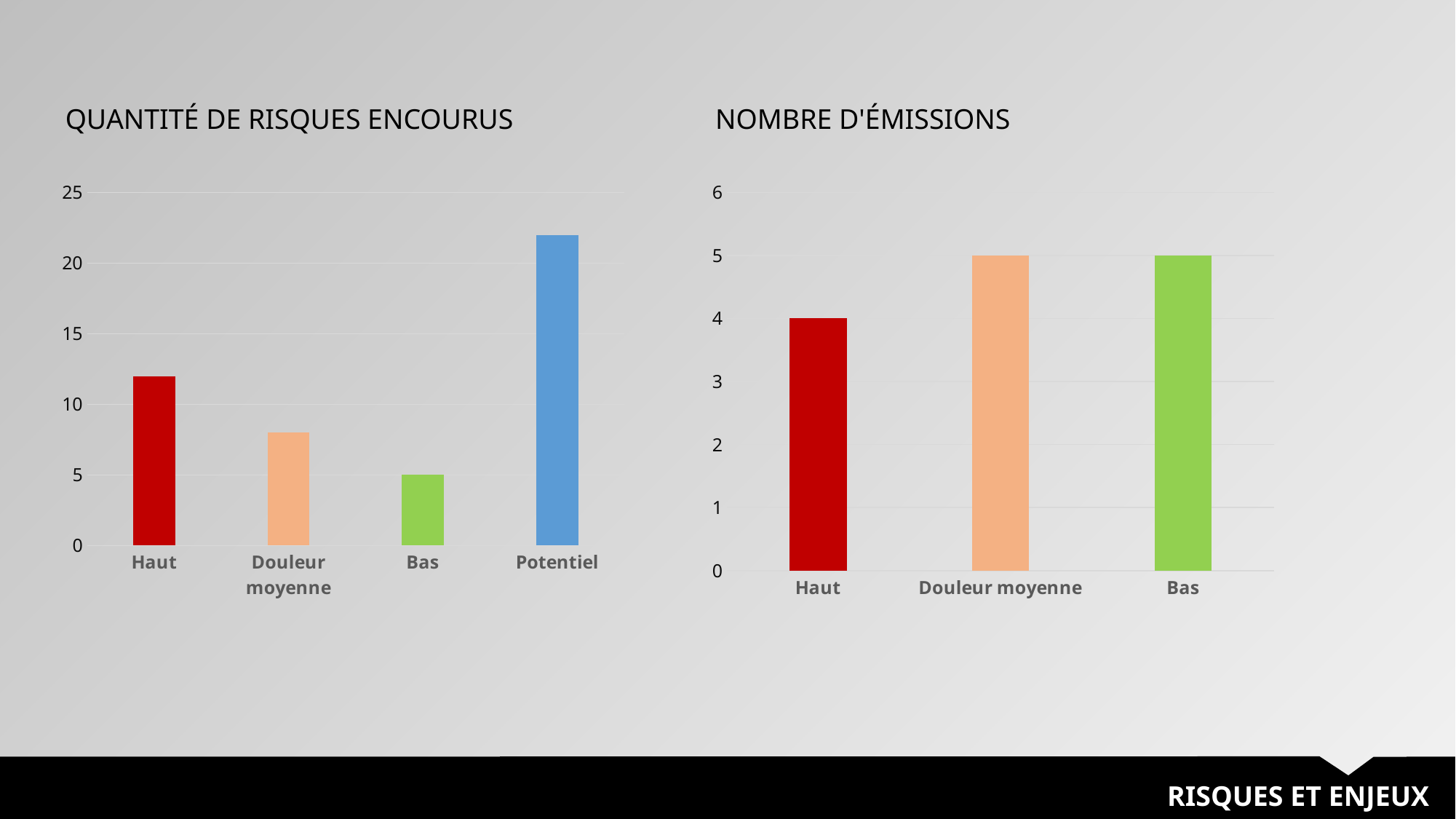
In the chart titled NOMBRE D'ÉMISSIONS, what is the value for Haut? 4 In the chart titled QUANTITÉ DE RISQUES ENCOURUS, which is larger, Haut or Douleur moyenne? Haut In the chart titled NOMBRE D'ÉMISSIONS, what is the difference between the values for Bas and Haut? 1 In the chart titled QUANTITÉ DE RISQUES ENCOURUS, is the value for Potentiel greater or less than 20? greater What kind of chart is the chart titled NOMBRE D'ÉMISSIONS? Bar chart In the chart titled QUANTITÉ DE RISQUES ENCOURUS, how many categories are shown? 4 In the chart titled QUANTITÉ DE RISQUES ENCOURUS, which category has the highest value? Potentiel In the chart titled QUANTITÉ DE RISQUES ENCOURUS, which category has the lowest value? Bas In the chart titled QUANTITÉ DE RISQUES ENCOURUS, is the value for Haut greater or less than 15? less In the chart titled NOMBRE D'ÉMISSIONS, what is the value for Douleur moyenne? 5 In the chart titled QUANTITÉ DE RISQUES ENCOURUS, what is the value for Bas? 5 In the chart titled NOMBRE D'ÉMISSIONS, which category has the lowest value? Haut